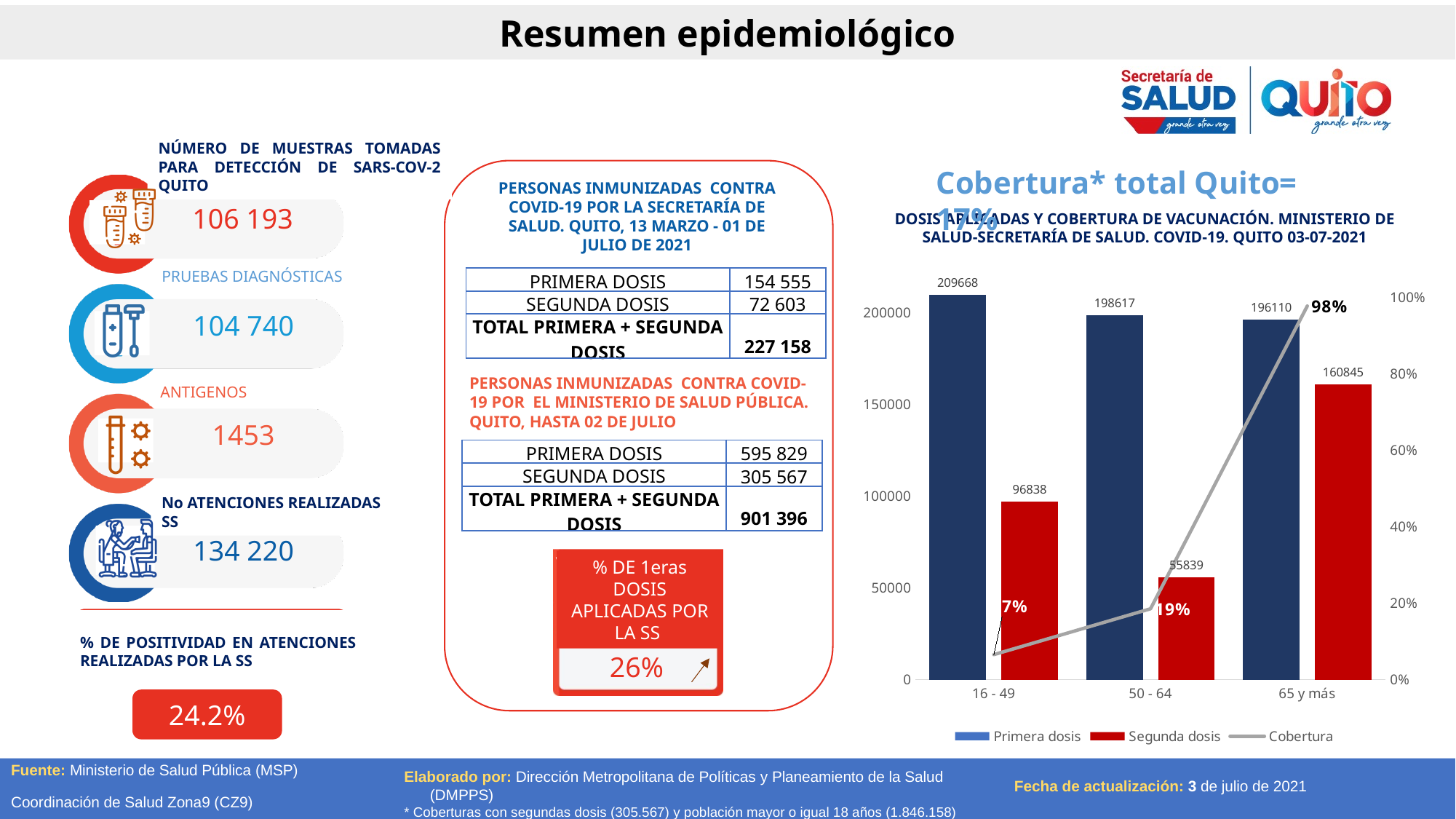
What colour are the Segunda dosis bars in the chart? Red What is the difference between Primera dosis and Segunda dosis for the 50 - 64 age group? 142778 Which age group has the highest Segunda dosis value? 65 y más What is the Cobertura percentage for the 50 - 64 age group? 19% How many series does the chart legend list? 3 Which age group has the lowest Segunda dosis value? 50 - 64 Is the Segunda dosis value for the 16 - 49 age group greater or less than 100000? less Which is larger for the 65 y más age group: Primera dosis or Segunda dosis? Primera dosis What is the value of Primera dosis for the 16 - 49 age group? 209668 What is the value of Segunda dosis for the 65 y más age group? 160845 Does the Cobertura line rise or fall from the 16 - 49 group to the 65 y más group? rise How many age groups are shown on the x axis of the chart? 3